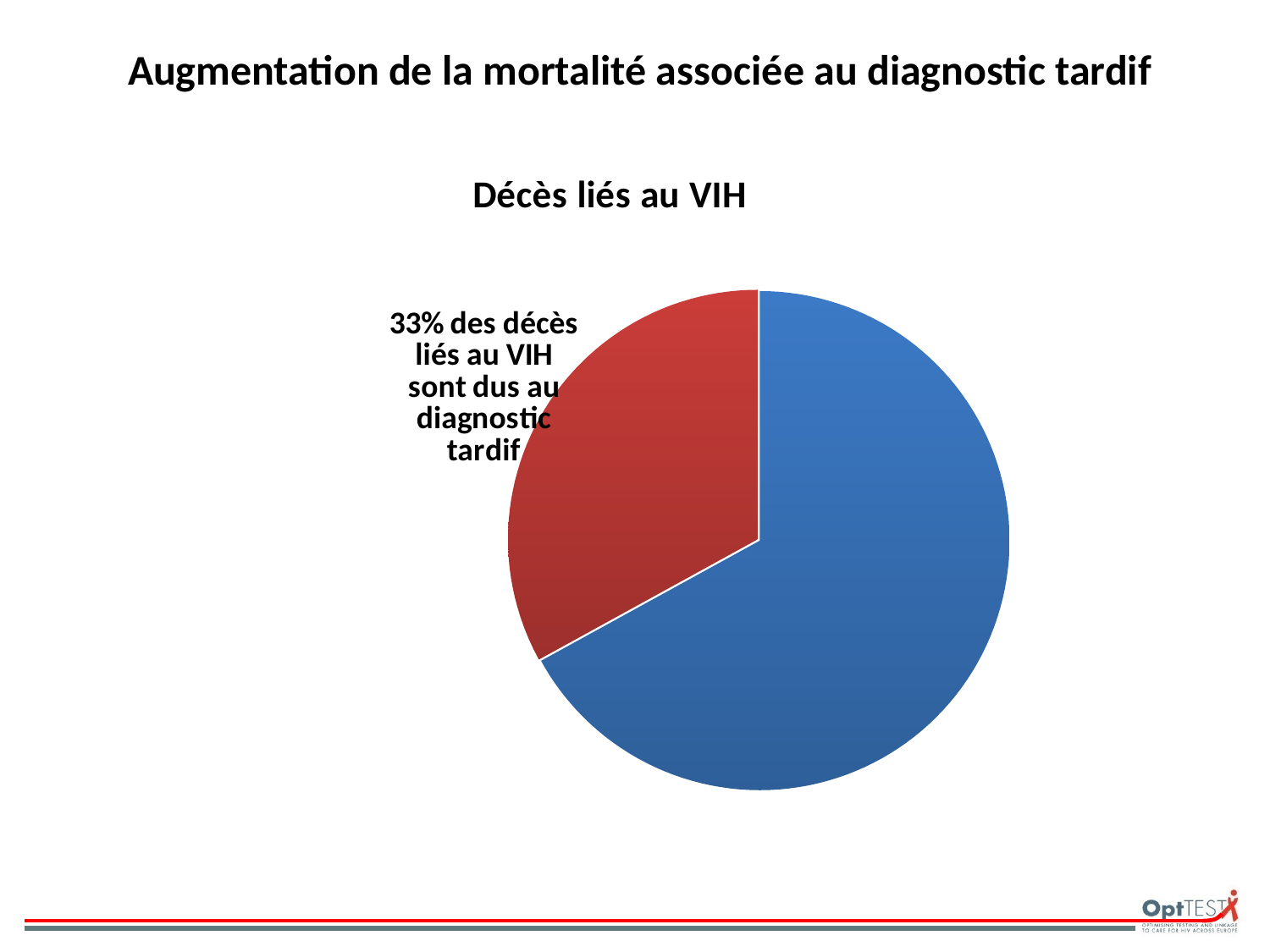
What is the title of the chart? Décès liés au VIH What share of the pie does the blue slice represent? 67% Which slice is larger, the red slice or the blue slice? the blue slice What kind of chart is shown on the slide? pie chart What percentage of HIV-related deaths are due to late diagnosis according to the chart? 33% What share of HIV-related deaths does the labelled slice attribute to late diagnosis? 33% What colour is the slice labelled '33% des décès liés au VIH sont dus au diagnostic tardif'? red Which slice of the pie is the smallest? the red slice (33% des décès liés au VIH sont dus au diagnostic tardif) How many slices does the pie chart have? 2